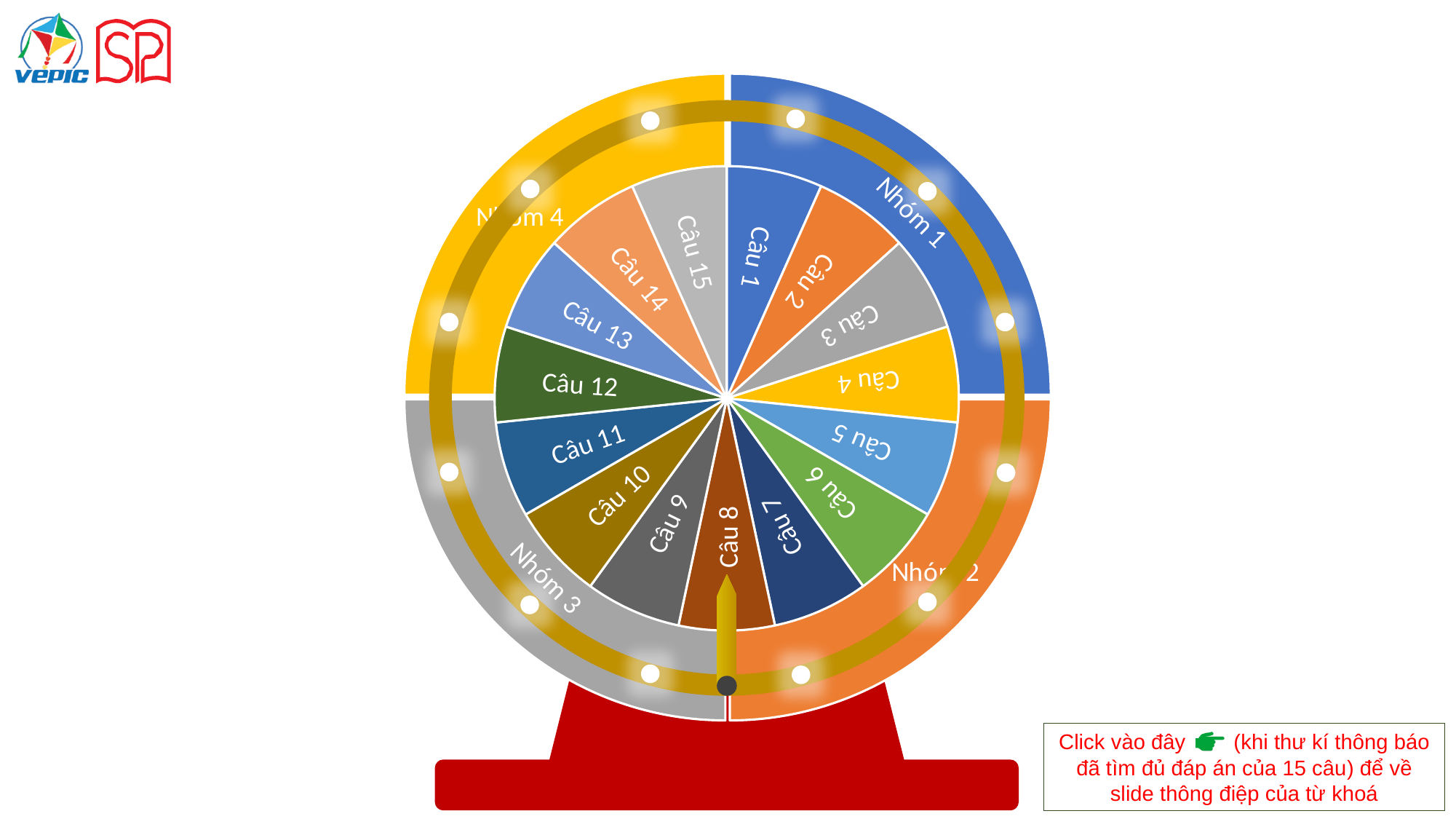
What is the label of the outer ring segment in the top-right quarter of the wheel? Nhóm 1 How many numbered slices (Câu) does the inner wheel contain? 15 How many groups (Nhóm) are labelled on the outer ring of the wheel? 4 What is the highest-numbered Câu slice on the inner wheel? Câu 15 What is the label of the outer ring segment in the bottom-left quarter of the wheel? Nhóm 3 What kind of chart is the inner wheel with the Câu slices? pie chart What is the label of the slice immediately clockwise from Câu 1 on the inner wheel? Câu 2 Which slice sits between Câu 14 and Câu 1 on the inner wheel? Câu 15 Which slice of the inner wheel is the pointer at the bottom of the wheel pointing to? Câu 8 What is the label of the outer ring segment in the top-left quarter of the wheel? Nhóm 4